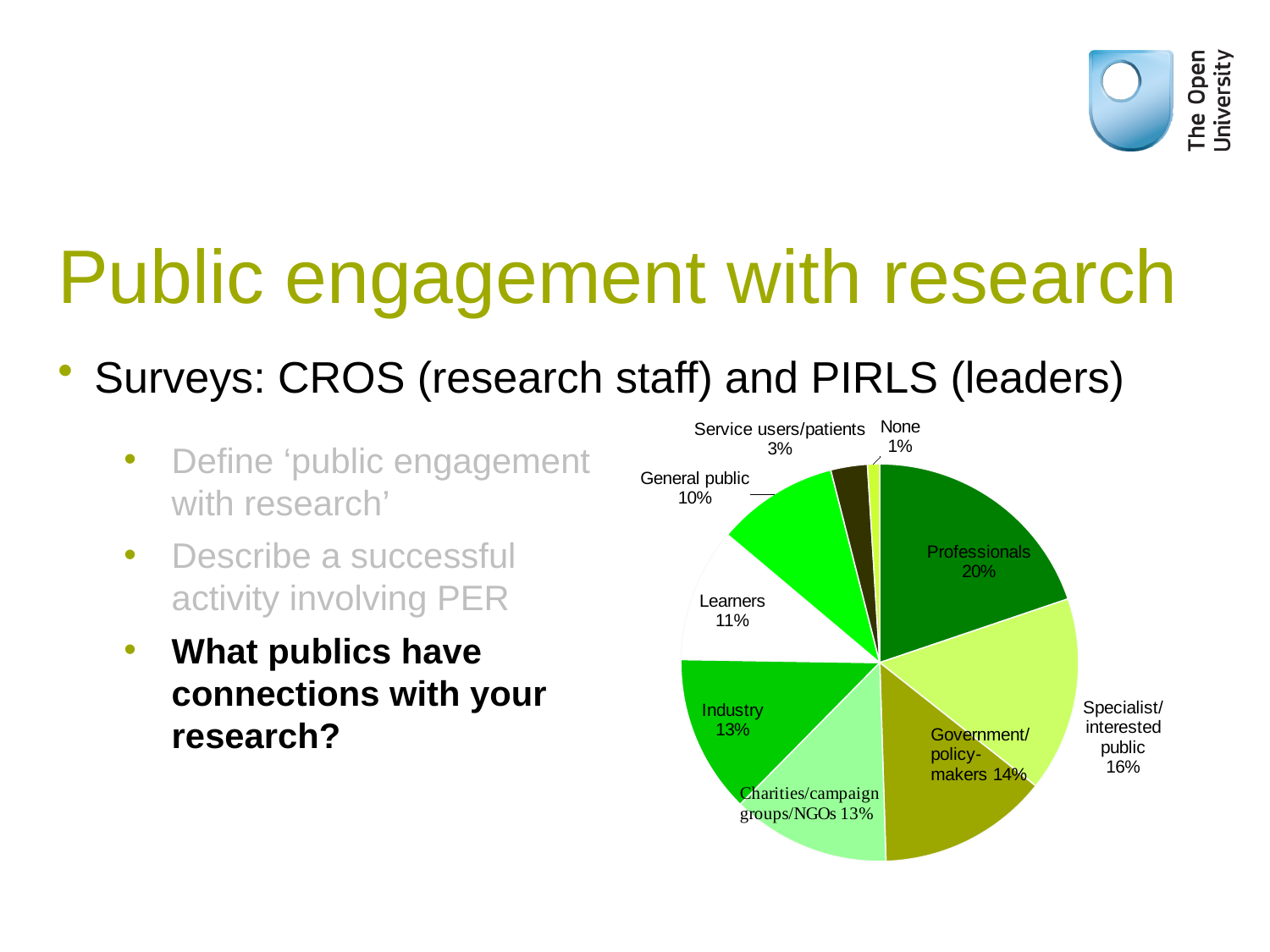
What percentage does the pie chart show for Learners? 11% What is the combined share of Industry and Charities/campaign groups/NGOs in the pie chart? 26% Which is larger in the pie chart, Specialist/interested public or Learners? Specialist/interested public What is the title of the slide containing the pie chart? Public engagement with research Which category has the largest slice of the pie chart? Professionals What kind of chart is shown on the slide? pie chart What share of the pie chart is labelled Professionals? 20% What is the difference in percentage points between Professionals and General public in the pie chart? 10 Which category has the smallest slice of the pie chart? None What percentage does the pie chart show for Government/policy-makers? 14% What percentage does the pie chart show for Service users/patients? 3% How many slices does the pie chart have? 9